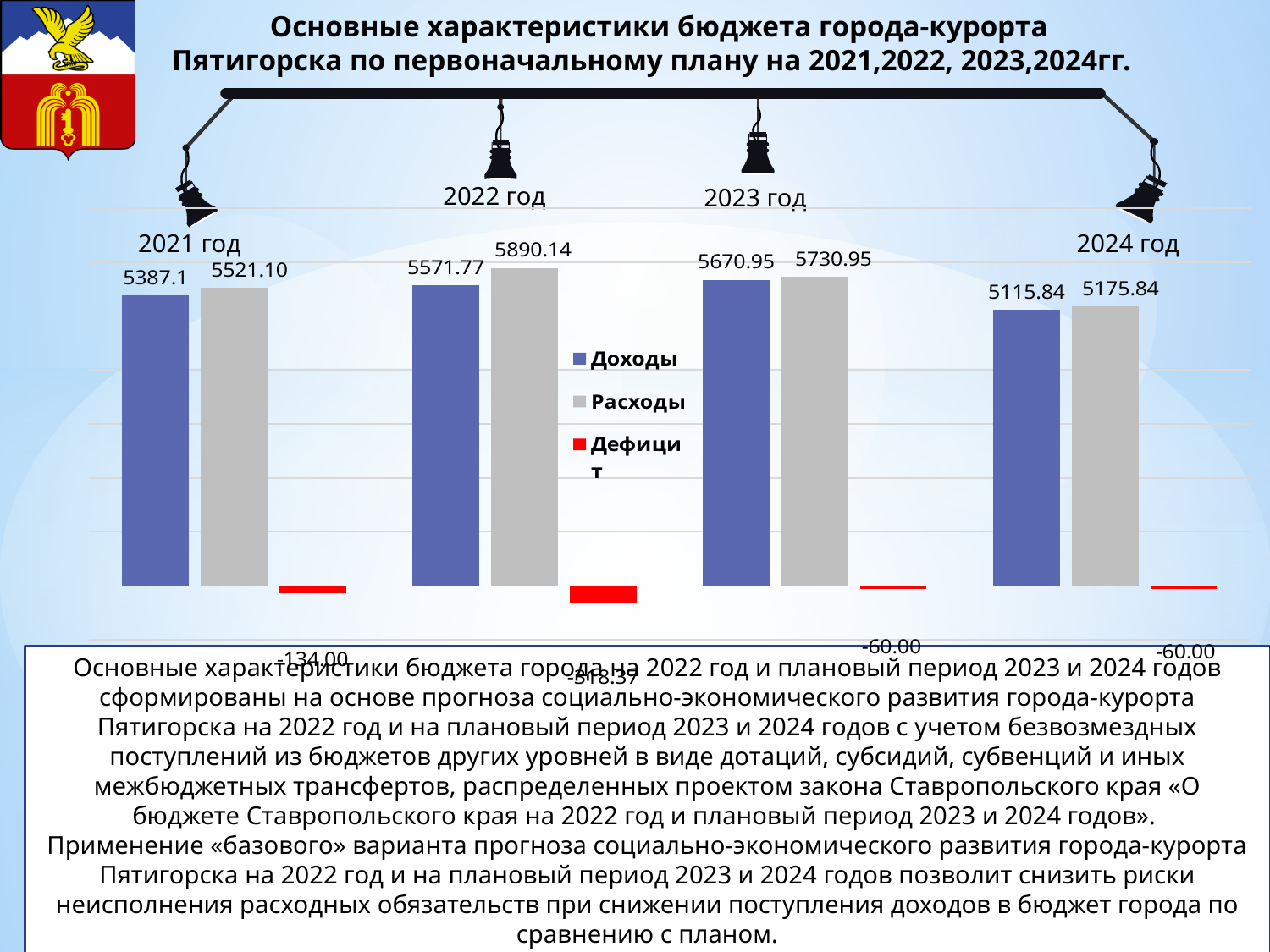
Which is larger for 2021 год, Доходы or Расходы? Расходы What kind of chart is shown on the slide? Bar chart What is the value of Дефицит for 2021 год? -134.00 How many series does the legend list? 3 What is the value of Доходы for 2022 год? 5571.77 What is the value of Расходы for 2023 год? 5730.95 Which year has the highest Расходы value? 2022 год What is the value of Доходы for 2024 год? 5115.84 Which year has the lowest Доходы value? 2024 год What colour are the Расходы bars? Gray What is the difference between Расходы and Доходы for 2022 год? 318.37 How many years are shown on the chart? 4